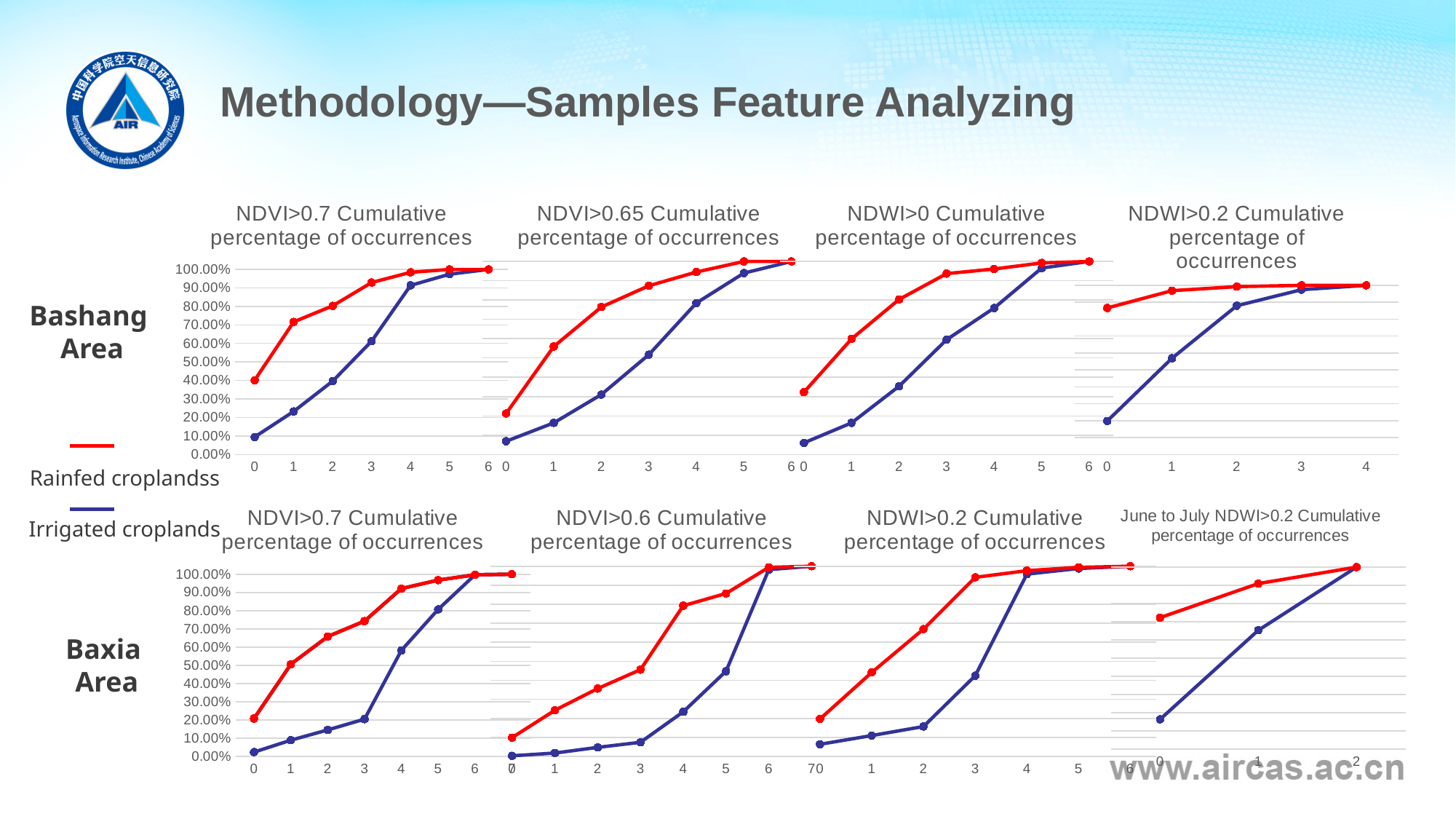
How many series does the legend on the slide list? 2 In the Baxia Area 'NDVI>0.6 Cumulative percentage of occurrences' chart, do the Irrigated croplands values rise or fall as x increases? Rise In the Bashang Area 'NDVI>0.7 Cumulative percentage of occurrences' chart, is the Rainfed croplands value at x=0 greater or less than 30.00%? greater In the Baxia Area 'June to July NDWI>0.2 Cumulative percentage of occurrences' chart, how many x-axis points are plotted for each series? 3 What kind of chart is the 'NDVI>0.7 Cumulative percentage of occurrences' chart for the Bashang Area? Line chart In the Bashang Area 'NDWI>0.2 Cumulative percentage of occurrences' chart, is the Rainfed croplands value at x=0 greater or less than 70.00%? greater In the Baxia Area 'NDWI>0.2 Cumulative percentage of occurrences' chart, is the Irrigated croplands value at x=0 greater or less than 10.00%? less In the Bashang Area 'NDVI>0.7 Cumulative percentage of occurrences' chart, which series has the larger value at x=1, Rainfed croplands or Irrigated croplands? Rainfed croplands In the Bashang Area 'NDVI>0.7 Cumulative percentage of occurrences' chart, how many x-axis points are plotted for each series? 7 In the Bashang Area 'NDWI>0.2 Cumulative percentage of occurrences' chart, how many x-axis points are plotted for each series? 5 Which colour represents Rainfed croplands in the charts? Red